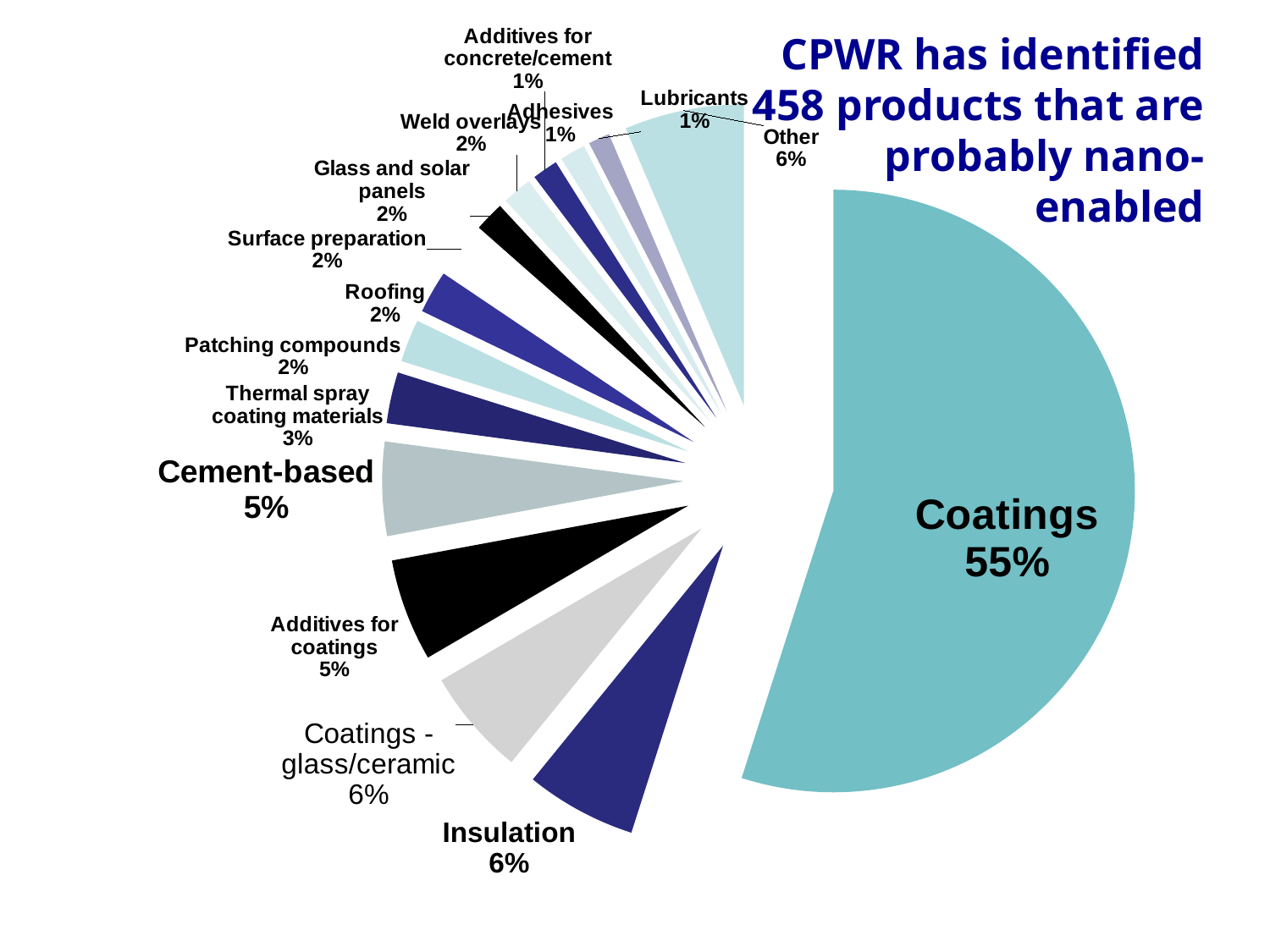
What is the value shown for Lubricants? 1% What is the value shown for Thermal spray coating materials? 3% What is the value shown for Insulation? 6% What kind of chart is shown on the slide? pie chart What share of the pie does Coatings account for? 55% Which category has the largest slice of the pie? Coatings What is the value shown for Additives for coatings? 5% How many categories are shown in the pie chart? 15 What is the difference between the Coatings share and the Insulation share? 49% According to the slide title, how many products has CPWR identified as probably nano-enabled? 458 Which is larger, the share for Cement-based or the share for Roofing? Cement-based What is the difference between the Cement-based share and the Thermal spray coating materials share? 2%